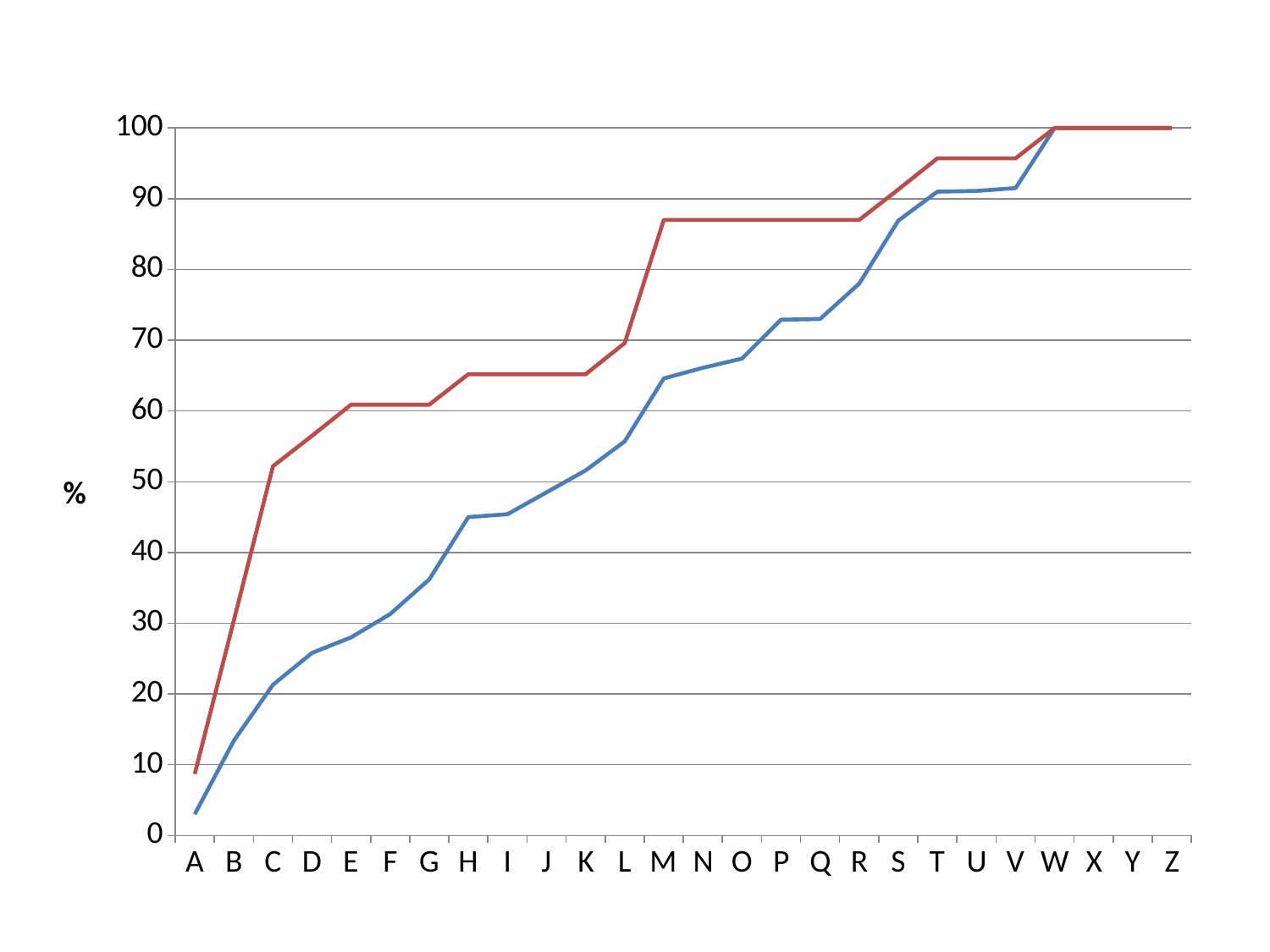
At which category does the blue line first reach 100? W At which category is the blue line at its lowest value? A What kind of chart is shown on the slide? line chart Is the value of the red line at M greater or less than 80? greater Is the value of the blue line at M greater or less than 70? less Is the value of the red line at C greater or less than 50? greater How many categories are shown on the x axis? 26 How many lines are plotted on the chart? 2 Do the values of the red line rise or fall from A to Z? rise At category M, which line has the higher value, the red line or the blue line? the red line What is the value of the blue line at Z? 100 What is the value of the red line at X? 100